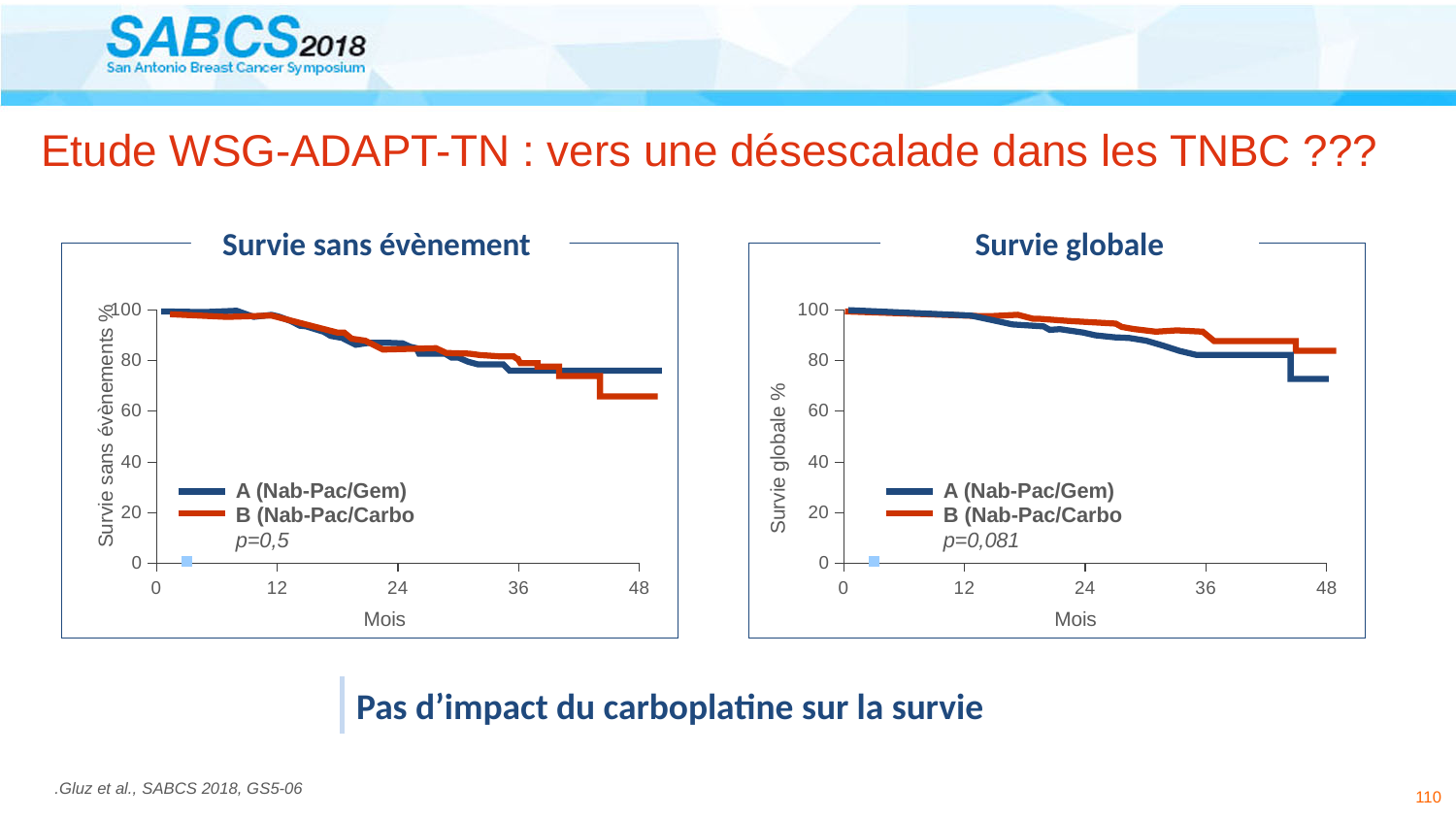
In the 'Survie sans évènement' chart, is the value for A (Nab-Pac/Gem) at 48 months greater or less than 60? greater What kind of chart is the 'Survie sans évènement' chart? Line chart In the 'Survie globale' chart, is the value for B (Nab-Pac/Carbo) at 48 months greater or less than 60? greater In the 'Survie sans évènement' chart, is the value for B (Nab-Pac/Carbo) at 48 months greater or less than 80? less How many tick labels are shown on the x axis of the 'Survie globale' chart? 5 In the 'Survie globale' chart, which series has the higher value at 48 months, A (Nab-Pac/Gem) or B (Nab-Pac/Carbo)? B (Nab-Pac/Carbo) What p-value is shown on the 'Survie globale' chart? p=0,081 What is the y-axis label of the 'Survie globale' chart? Survie globale % How many series does the legend of the 'Survie globale' chart list? 2 What is the highest value shown on the x axis of the 'Survie sans évènement' chart? 48 In the 'Survie sans évènement' chart, do the curves rise or fall as months increase? Fall